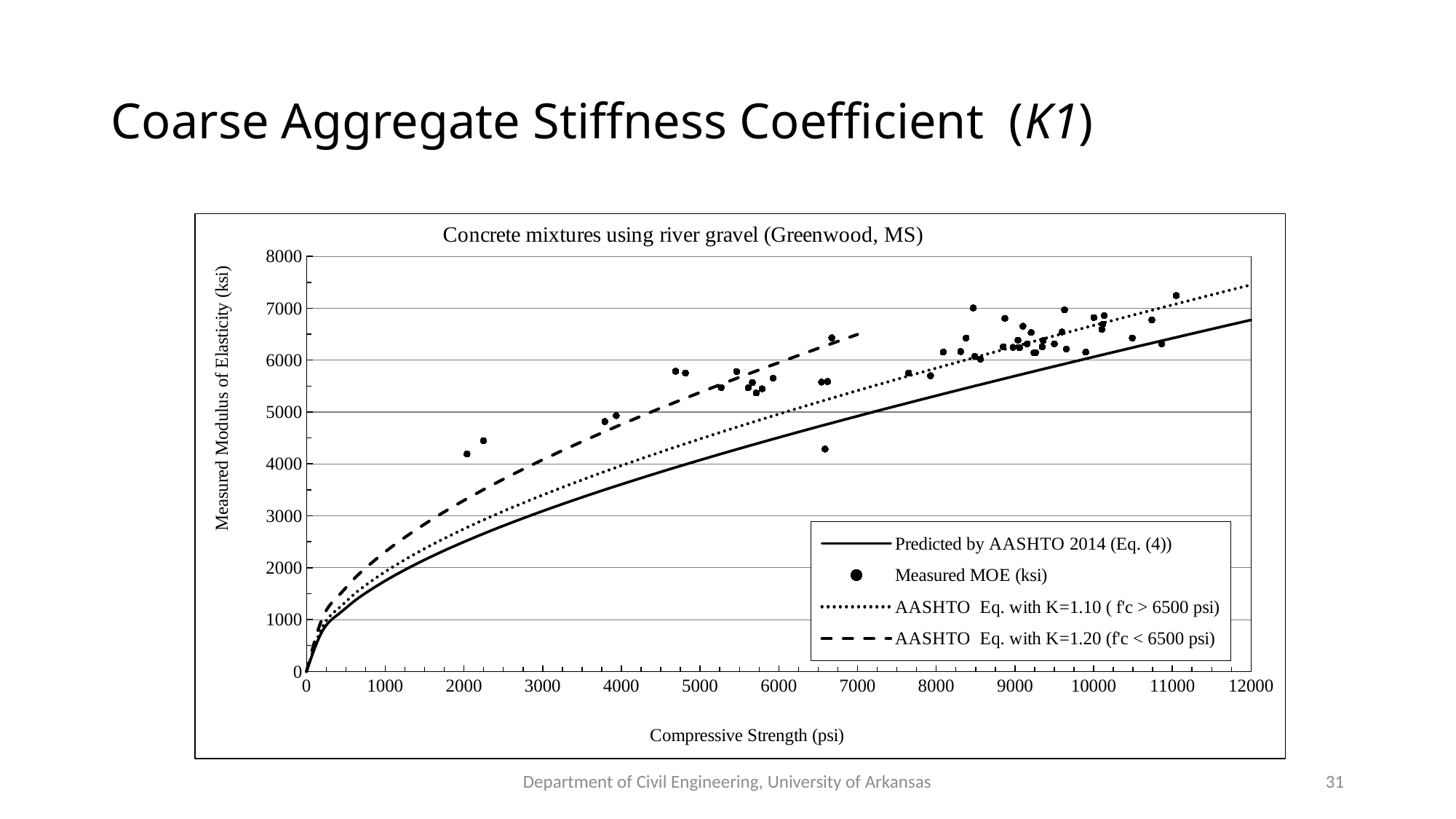
What is the label of the x axis? Compressive Strength (psi) How many series does the chart legend list? 4 At 5000 psi, which of the three plotted lines is the lowest? Predicted by AASHTO 2014 (Eq. (4)) Do the predicted AASHTO curves rise or fall as compressive strength increases? rise What is the title of the chart? Concrete mixtures using river gravel (Greenwood, MS) Is the value of the 'Predicted by AASHTO 2014 (Eq. (4))' line at 4000 psi greater or less than 4000? less Is the value of the 'AASHTO Eq. with K=1.10' line at 12000 psi greater or less than 7000? greater Is the value of the 'AASHTO Eq. with K=1.20' line at 4000 psi greater or less than 4000? greater What kind of chart is shown on the slide? scatter chart At 5000 psi, which of the three plotted lines is the highest? AASHTO Eq. with K=1.20 (f'c < 6500 psi) At 12000 psi, which line is higher: 'Predicted by AASHTO 2014 (Eq. (4))' or 'AASHTO Eq. with K=1.10'? AASHTO Eq. with K=1.10